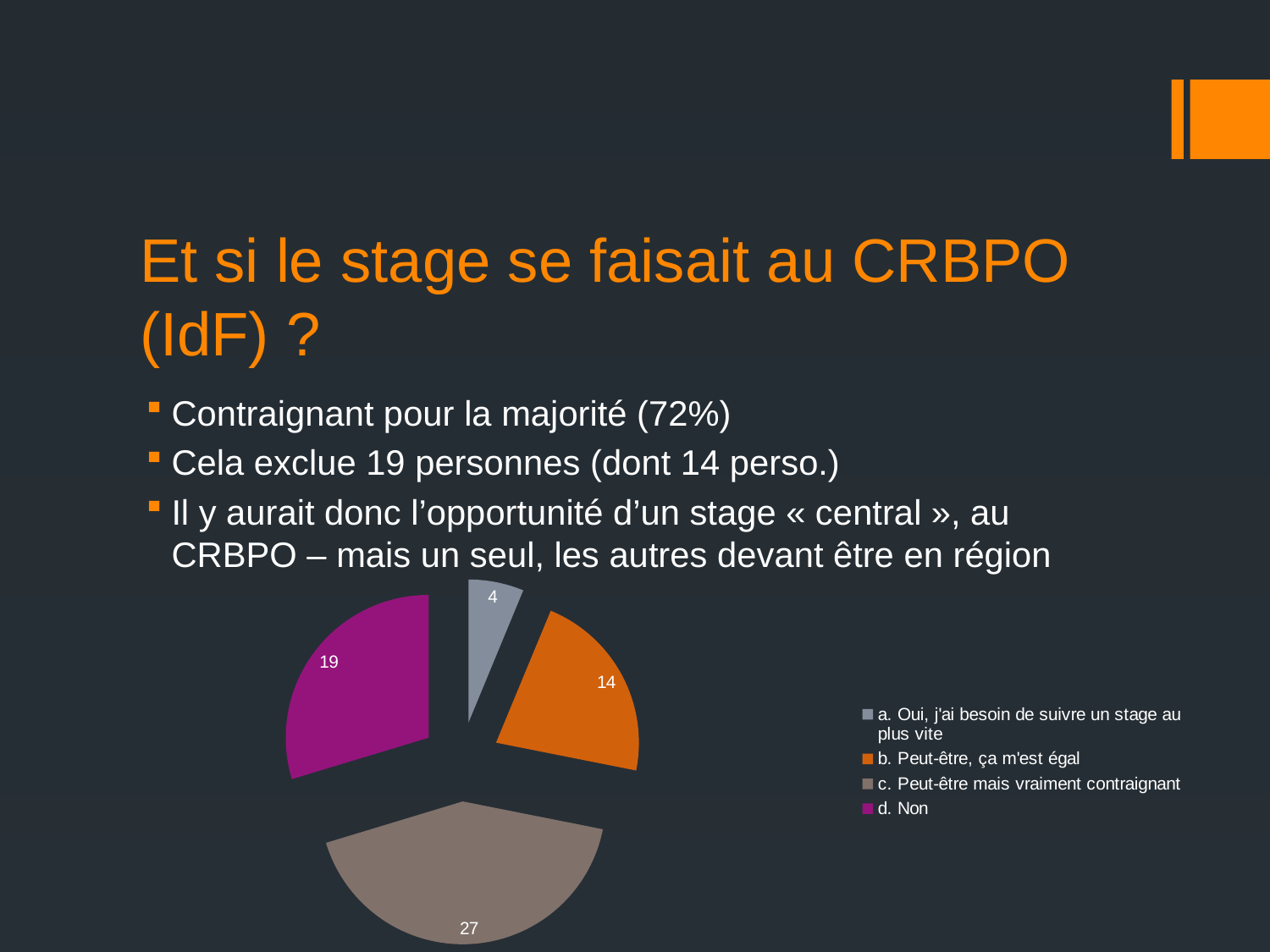
What is the value for "b. Peut-être, ça m'est égal" in the pie chart? 14 What kind of chart is shown on the slide? pie chart Which category has the largest slice in the pie chart? c. Peut-être mais vraiment contraignant How many entries does the legend of the pie chart list? 4 Which is larger in the pie chart: "d. Non" or "b. Peut-être, ça m'est égal"? d. Non What is the value for "a. Oui, j'ai besoin de suivre un stage au plus vite" in the pie chart? 4 What is the total of all the slices in the pie chart? 64 How many slices does the pie chart have? 4 What is the difference between the values for "c. Peut-être mais vraiment contraignant" and "d. Non"? 8 What is the value for "d. Non" in the pie chart? 19 What colour is the slice for "d. Non" in the pie chart? magenta Which category has the smallest slice in the pie chart? a. Oui, j'ai besoin de suivre un stage au plus vite